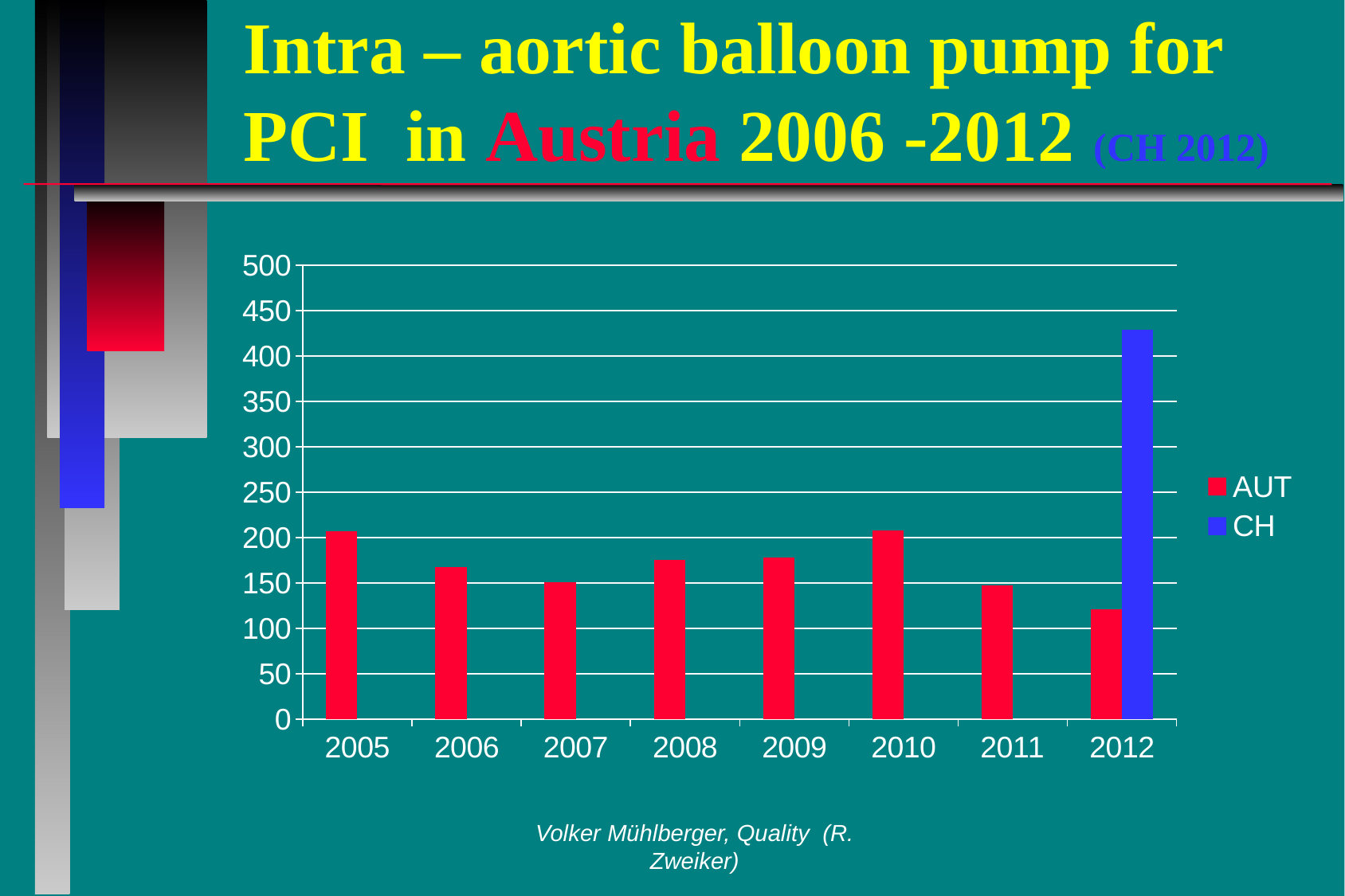
Is the CH value for 2012 greater or less than 400? greater Which is larger, the AUT value for 2009 or for 2011? 2009 Is the AUT value for 2007 greater or less than 200? less Is the AUT value for 2012 greater or less than 100? greater How many years are shown on the x axis? 8 What kind of chart is shown on the slide? bar chart Which bar is the tallest in the chart? CH in 2012 How many series does the legend list? 2 In 2012, which is larger, the AUT value or the CH value? CH Which year has the lowest AUT value? 2012 Do the AUT values rise or fall from 2010 to 2012? fall